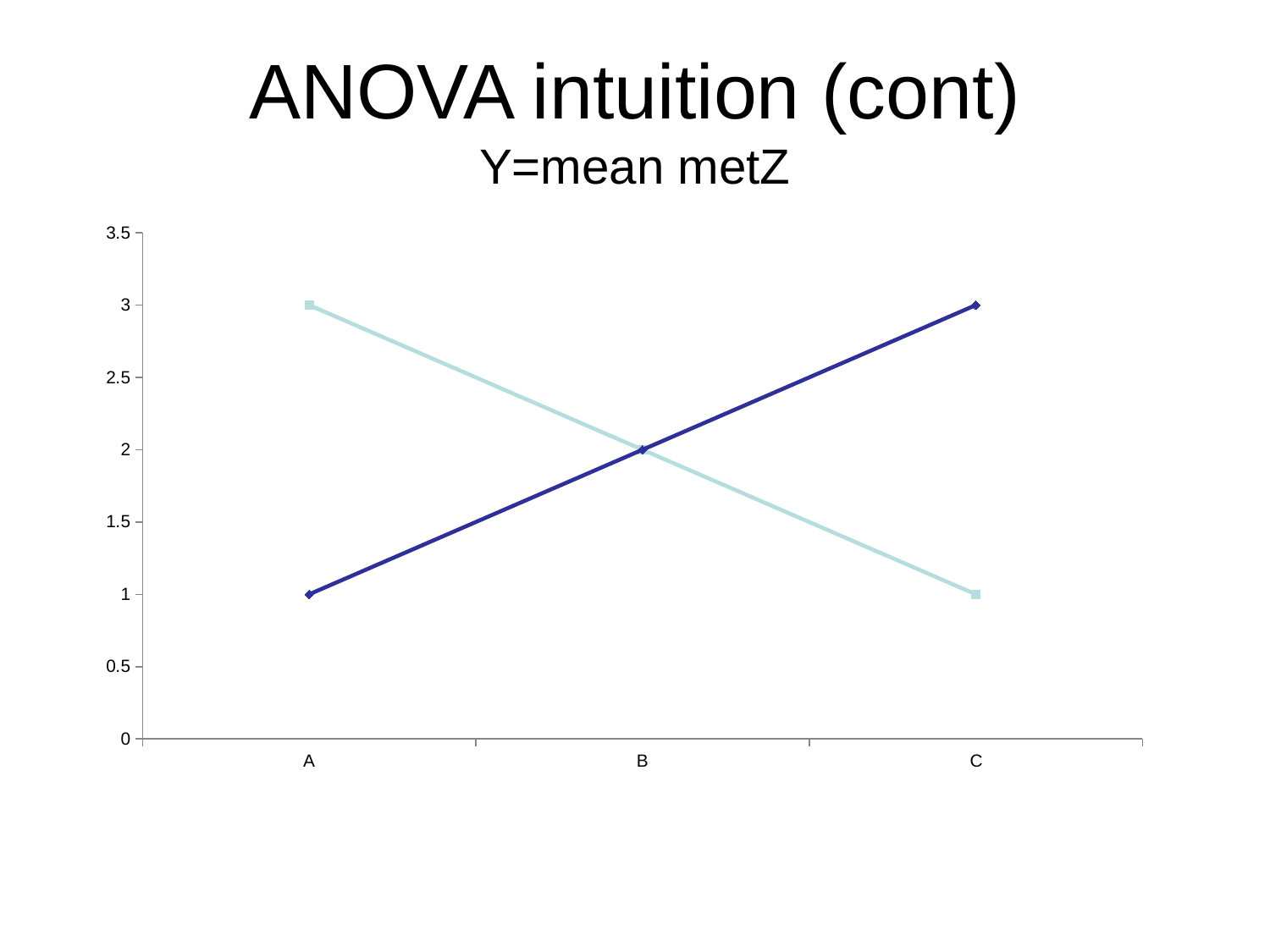
What is the value of the light blue line at A? 3 What is the value of the dark blue line at C? 3 What is the value of the dark blue line at A? 1 What kind of chart is shown on the slide? line chart What is the difference between the dark blue line's value at C and its value at A? 2 At category A, which line has the larger value, the dark blue or the light blue? light blue At which category do the two lines have the same value? B How many categories are shown on the x axis? 3 How many lines are plotted on the chart? 2 Does the dark blue line rise or fall from A to C? rise Does the light blue line rise or fall from A to C? fall What is the value of the light blue line at C? 1